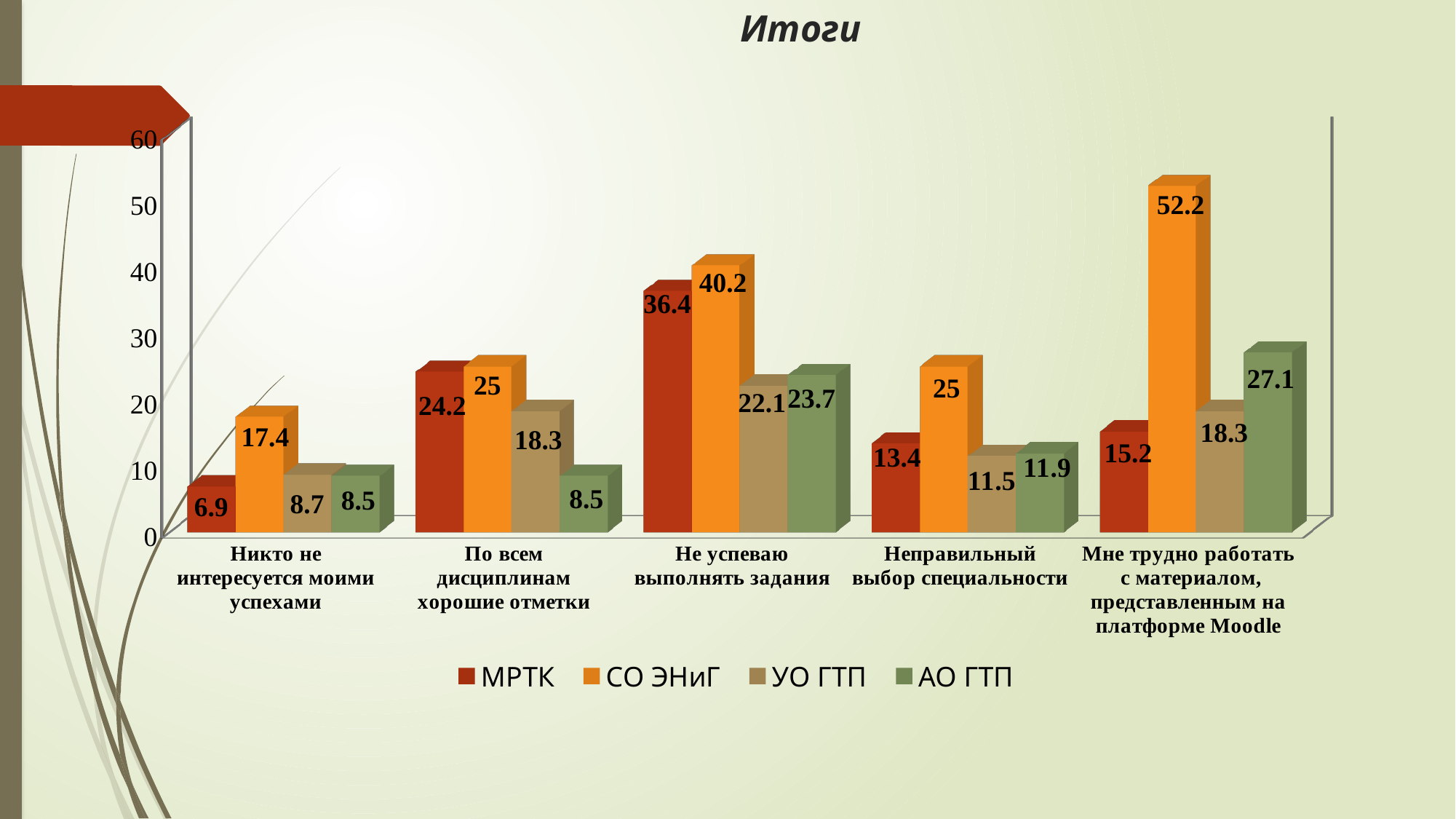
What is the value for СО ЭНиГ in the category "Мне трудно работать с материалом, представленным на платформе Moodle"? 52.2 What type of chart is shown on the slide? bar chart Which is larger in the category "Неправильный выбор специальности": the value for МРТК or the value for СО ЭНиГ? СО ЭНиГ What is the value for МРТК in the category "Не успеваю выполнять задания"? 36.4 How many categories are shown on the x axis? 5 What is the title of the chart? Итоги What is the value for АО ГТП in the category "Неправильный выбор специальности"? 11.9 Which series has the lowest value in the category "По всем дисциплинам хорошие отметки"? АО ГТП How many series does the legend list? 4 Which series has the highest value in the category "Мне трудно работать с материалом, представленным на платформе Moodle"? СО ЭНиГ What is the value for УО ГТП in the category "Никто не интересуется моими успехами"? 8.7 What is the difference between the СО ЭНиГ and МРТК values in the category "Не успеваю выполнять задания"? 3.8